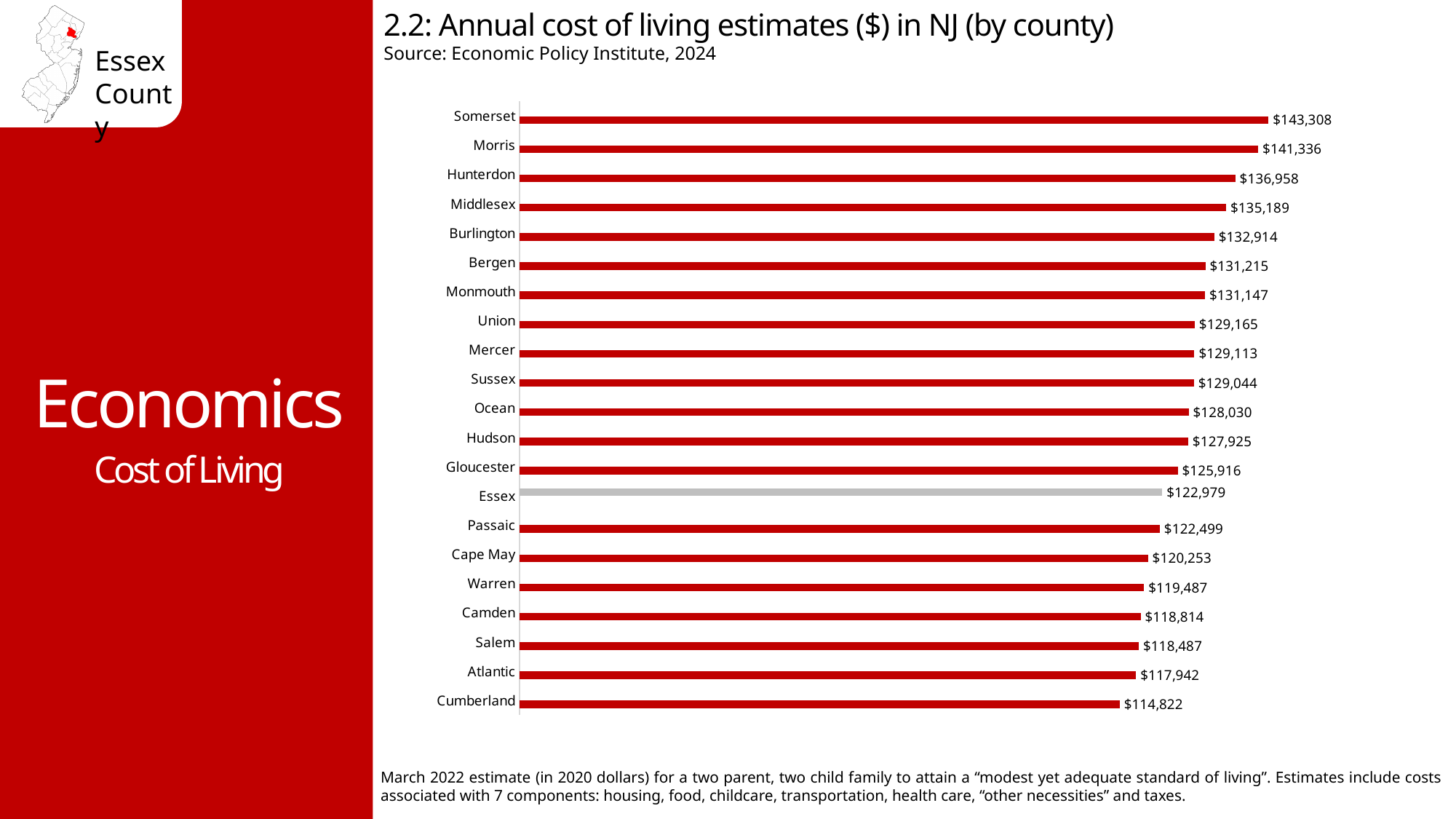
Which county has the highest annual cost of living estimate? Somerset Which county has the lowest annual cost of living estimate? Cumberland What is the difference between the cost of living estimates for Somerset and Cumberland? $28,486 Which county has a higher cost of living estimate, Hudson or Gloucester? Hudson What is the source cited for the chart? Economic Policy Institute, 2024 How many counties are shown in the chart? 21 Which county has a higher cost of living estimate, Camden or Cape May? Cape May What is the annual cost of living estimate for Bergen County? $131,215 What type of chart is used to show the annual cost of living estimates? Bar chart What is the difference between the cost of living estimates for Essex and Passaic? $480 Which county's bar is shown in a different colour (grey) from the others? Essex What is the annual cost of living estimate for Essex County? $122,979